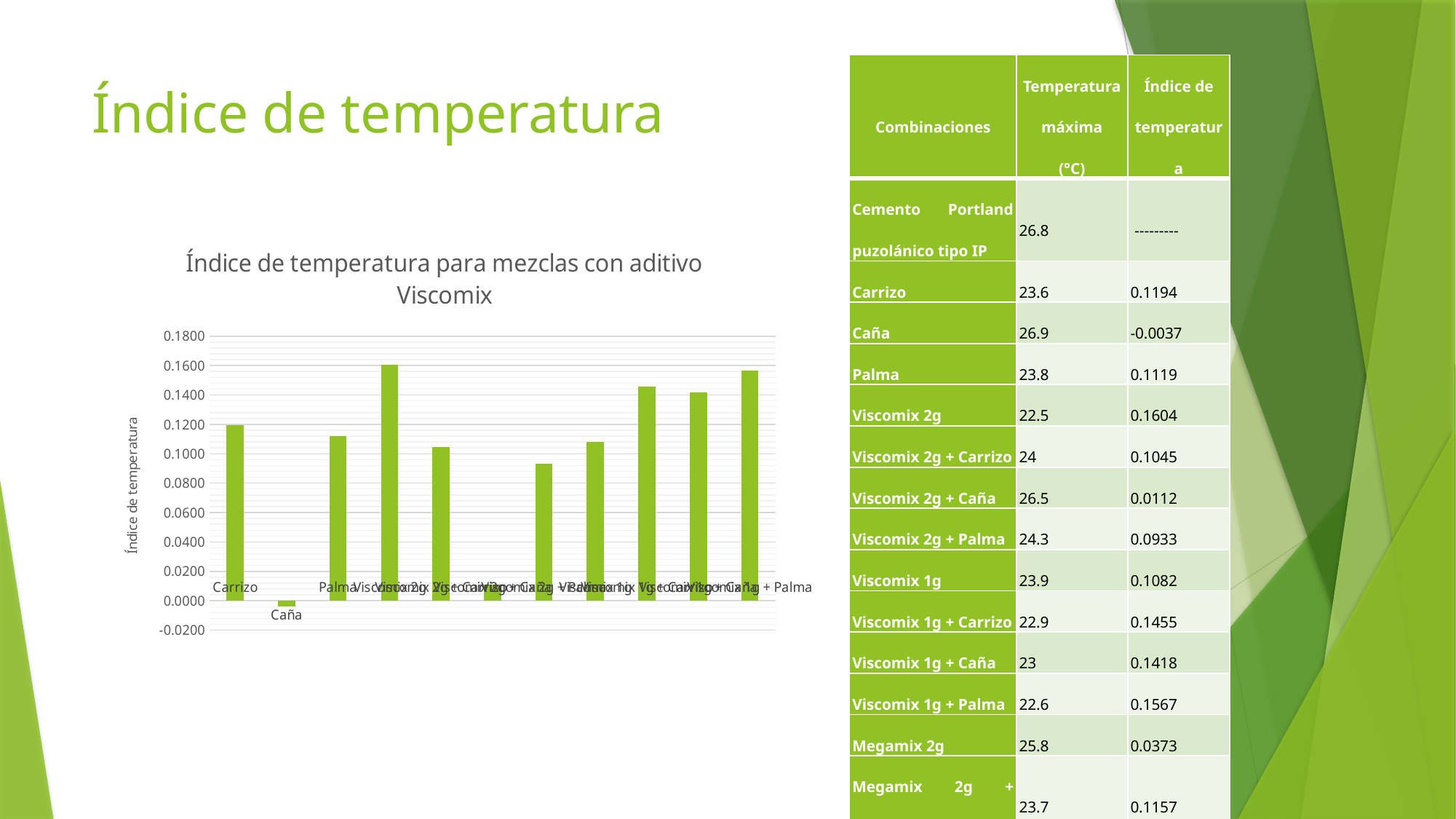
What is the label of the vertical axis of the chart? Índice de temperatura Which category has the lowest value in the chart? Caña What is the title of the chart on the slide? Índice de temperatura para mezclas con aditivo Viscomix How many bars in the chart have a negative value? 1 Is the value for Carrizo greater or less than 0.1000? greater How many bars are plotted in the chart? 11 Which is larger in the chart, the value for Palma or the value for Caña? Palma What type of chart is shown on the slide? bar chart Is the value for Caña greater or less than 0.0000? less Which is larger in the chart, the value for Carrizo or the value for Caña? Carrizo Is the value for Palma greater or less than 0.1000? greater What is the highest tick value shown on the vertical axis of the chart? 0.1800